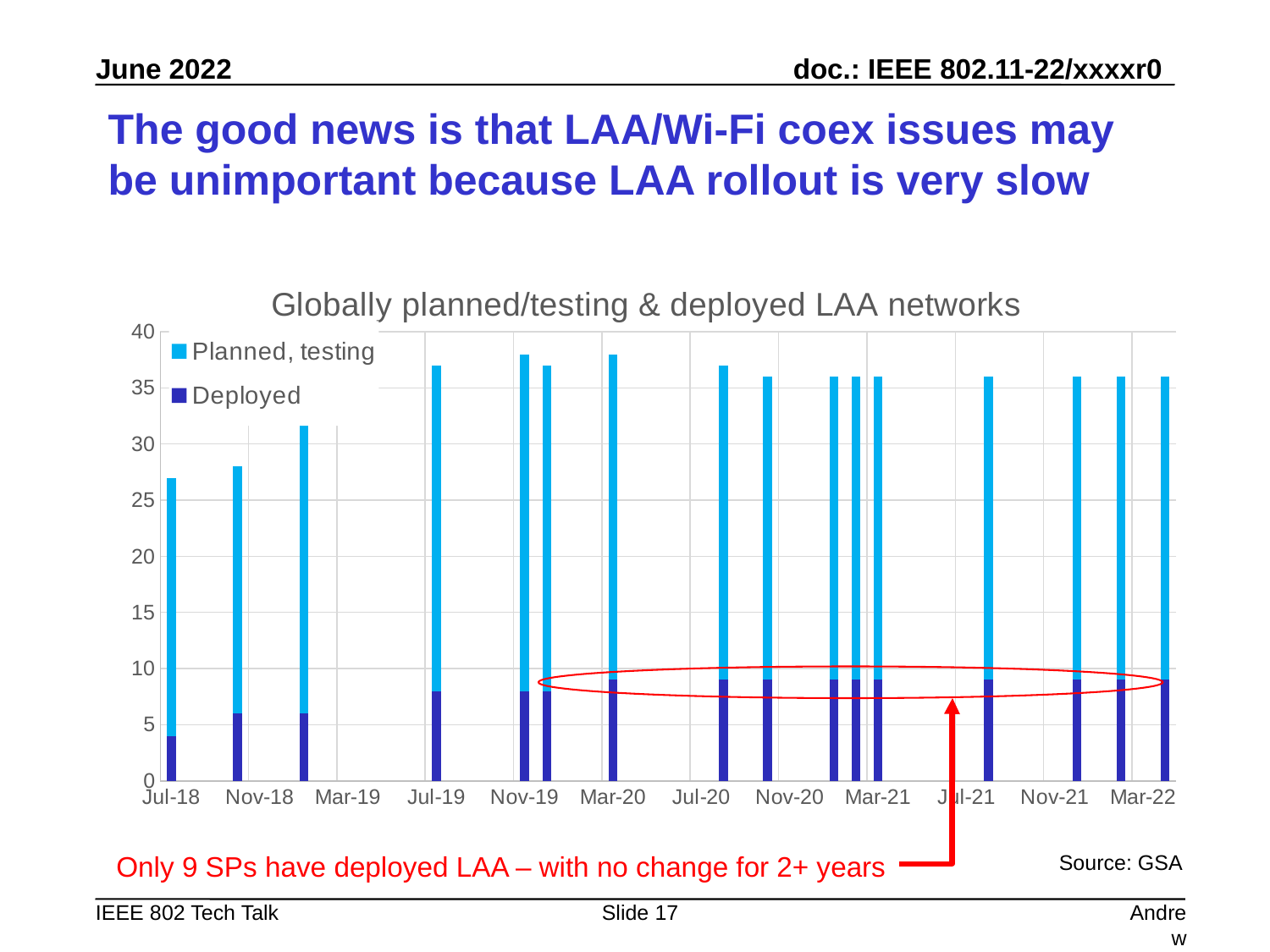
Is the total height of the Jul-18 bar greater or less than 25? greater What are the two series named in the chart legend? Planned, testing; Deployed What is the title of the chart? Globally planned/testing & deployed LAA networks Is the Deployed value for Jul-18 greater or less than 5? less Which date has the lowest total bar height in the chart? Jul-18 Do the total bar heights generally rise or fall from Jul-18 to Mar-22? rise Is the total height of the Nov-18 bar greater or less than 30? less What kind of chart is shown on the slide? Stacked bar chart How many series does the chart legend list? 2 Which bar has the larger total, Jul-18 or Jul-19? Jul-19